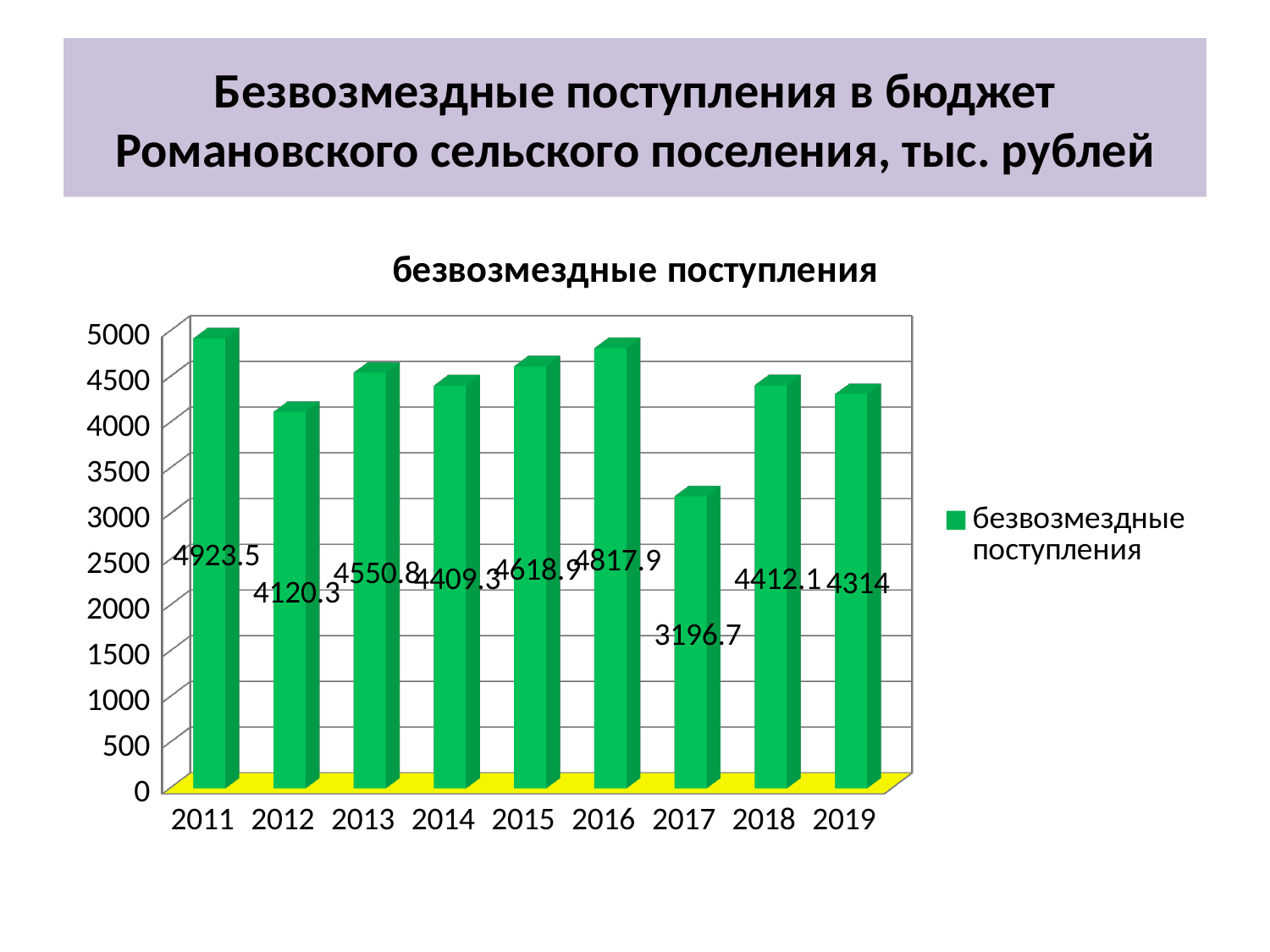
What is the title of the chart? безвозмездные поступления Which year has the highest value? 2011 Is the value for 2017 greater or less than 3500? less How many series does the legend list? 1 What is the value for 2019? 4314 What is the value for 2017? 3196.7 Which is larger, the value for 2013 or the value for 2014? 2013 What is the difference between the values for 2011 and 2017? 1726.8 What kind of chart is shown? bar chart Which year has the lowest value? 2017 What is the value for 2011? 4923.5 How many years are shown on the x axis? 9